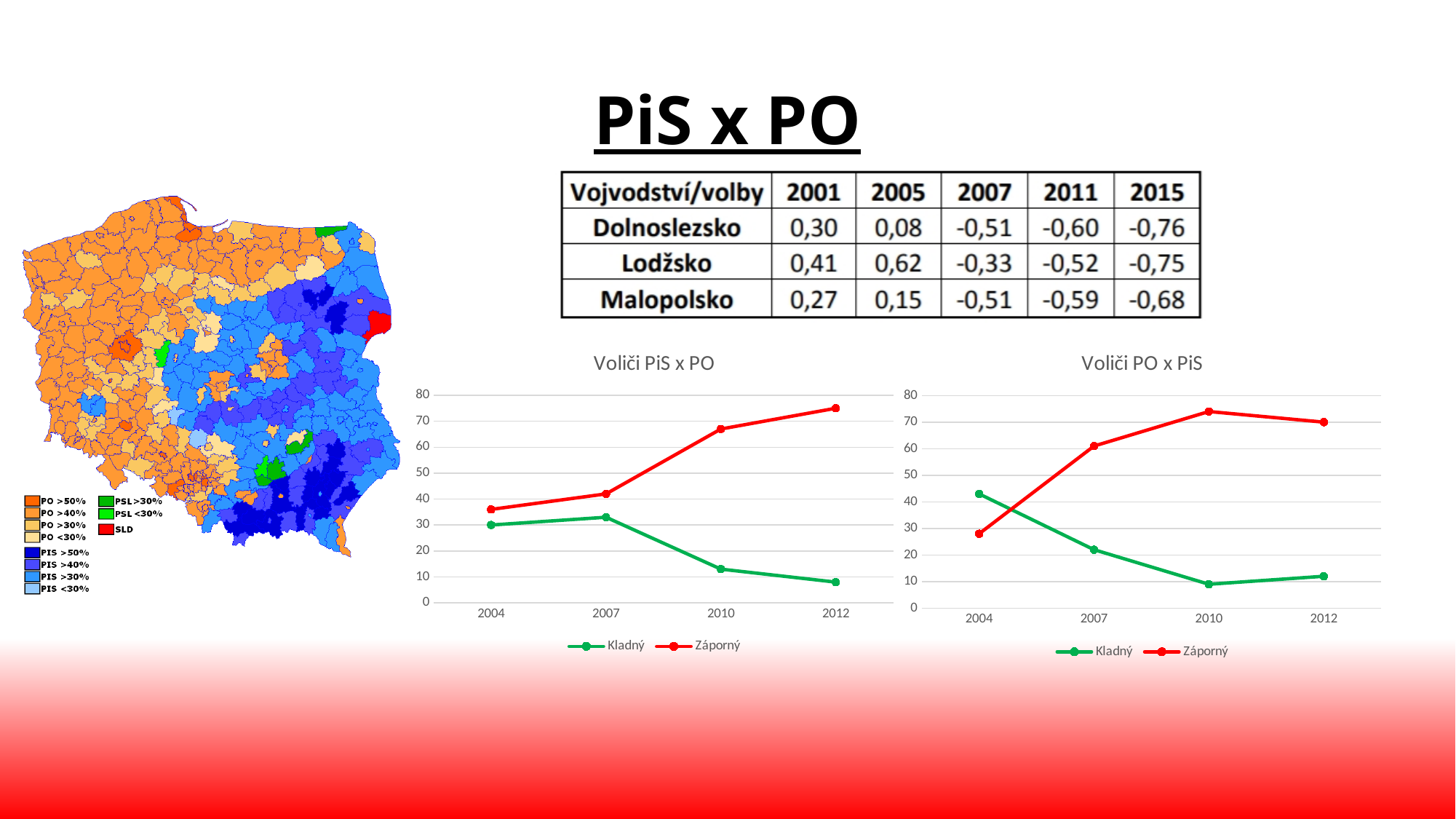
How many years are plotted on the x axis of the "Voliči PiS x PO" chart? 4 What are the two legend entries of the "Voliči PiS x PO" chart? Kladný and Záporný In the "Voliči PO x PiS" chart, is the Kladný value for 2004 greater or less than 40? greater In the "Voliči PO x PiS" chart, is the Záporný value for 2004 greater or less than 30? less What kind of chart is the "Voliči PiS x PO" chart? line chart In the "Voliči PO x PiS" chart, does the Kladný series rise or fall from 2004 to 2010? fall In the "Voliči PiS x PO" chart, is the Záporný value for 2012 greater or less than 70? greater In the "Voliči PiS x PO" chart, does the Záporný series rise or fall from 2004 to 2012? rise How many series does the legend of the "Voliči PO x PiS" chart list? 2 In the "Voliči PO x PiS" chart, in which year is the Záporný series highest? 2010 In the "Voliči PiS x PO" chart, which series has the larger value in 2007, Kladný or Záporný? Záporný